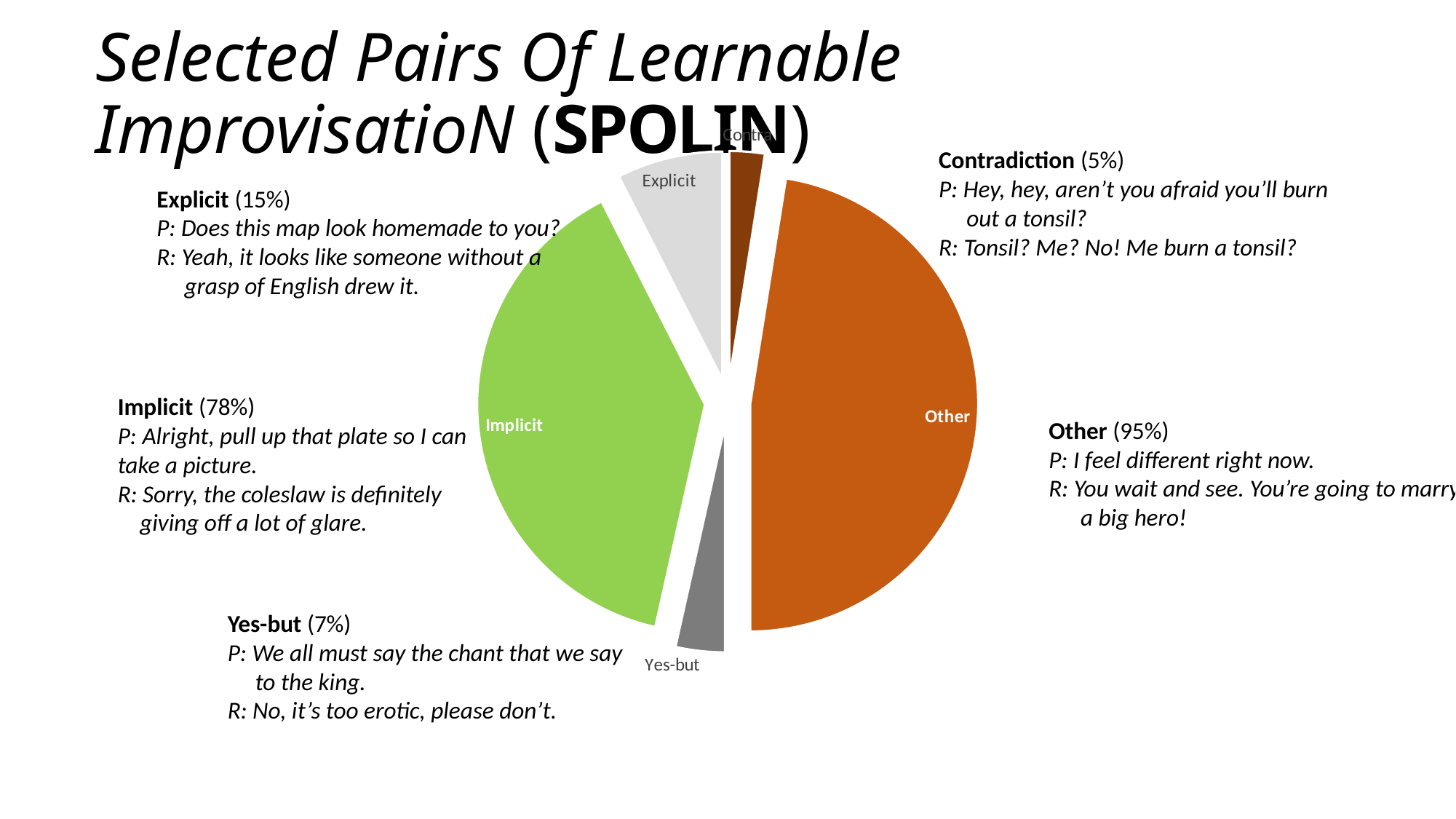
Is the Implicit slice greater or less than half of the pie? less How many slices does the pie chart have? 5 What kind of chart is shown on the slide? pie chart What colour is the Other slice of the pie chart? orange Which slice is larger in the pie chart, Other or Implicit? Other Which slice is larger in the pie chart, Implicit or Explicit? Implicit Which slice of the pie chart is the largest? Other Which slice is larger in the pie chart, Implicit or Yes-but? Implicit What colour is the Implicit slice of the pie chart? green Is the Explicit slice greater or less than a quarter of the pie? less